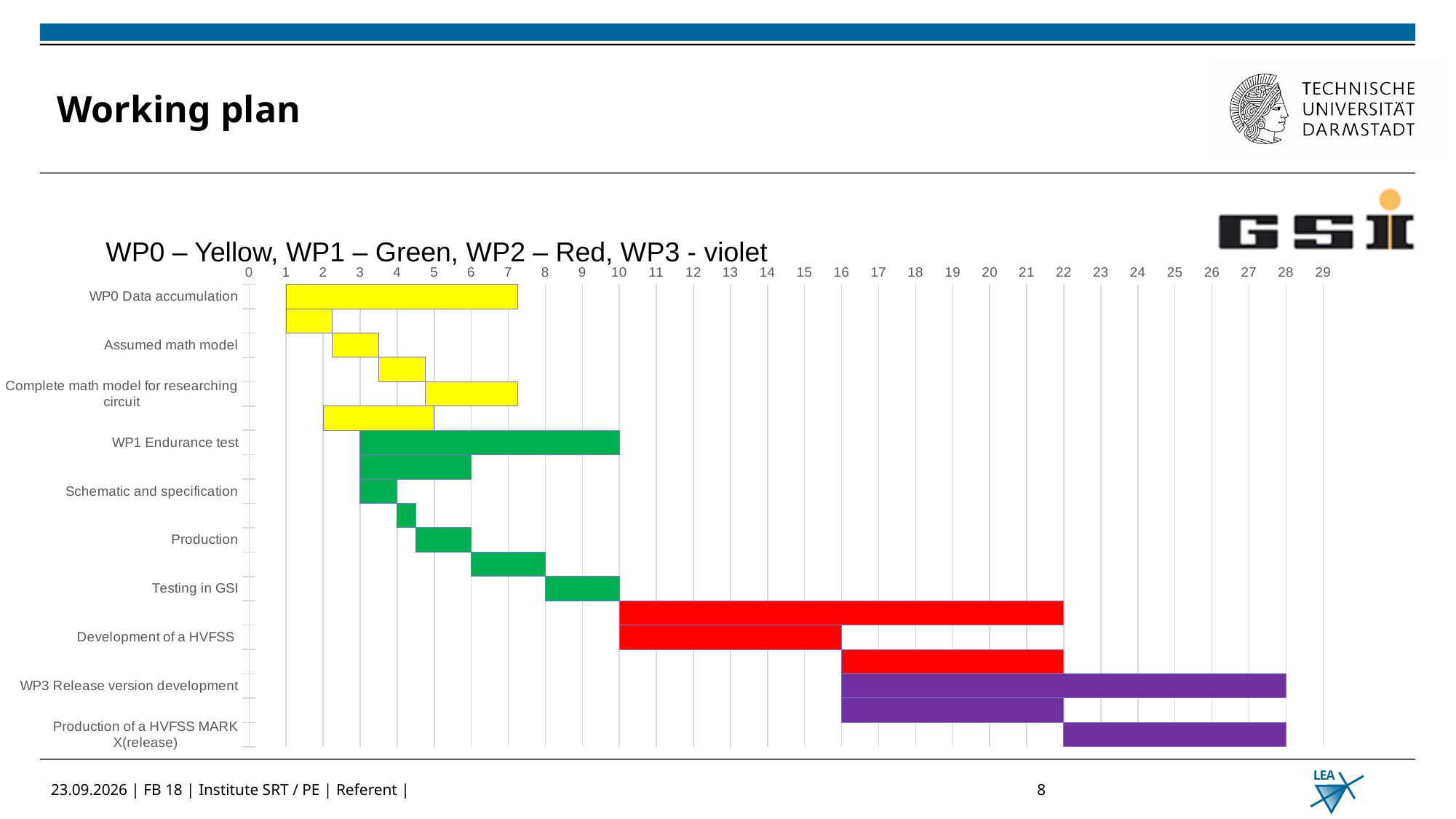
At which x-axis value does the WP1 Endurance test bar end? 10 How many units long is the WP3 Release version development bar (from 16 to 28)? 12 Does the Testing in GSI bar end before or after 12 on the x axis? Before At which x-axis value does the WP1 Endurance test bar start? 3 At which x-axis value does the WP3 Release version development bar end? 28 What kind of chart is shown on the slide? Bar chart (Gantt chart) According to the chart subtitle, which work package is shown in violet? WP3 According to the chart subtitle, which colour represents WP2? Red How many labelled categories are listed on the vertical axis of the chart? 10 At which x-axis value does the Development of a HVFSS bar start? 10 Which bar is longer, WP1 Endurance test or Development of a HVFSS? WP1 Endurance test